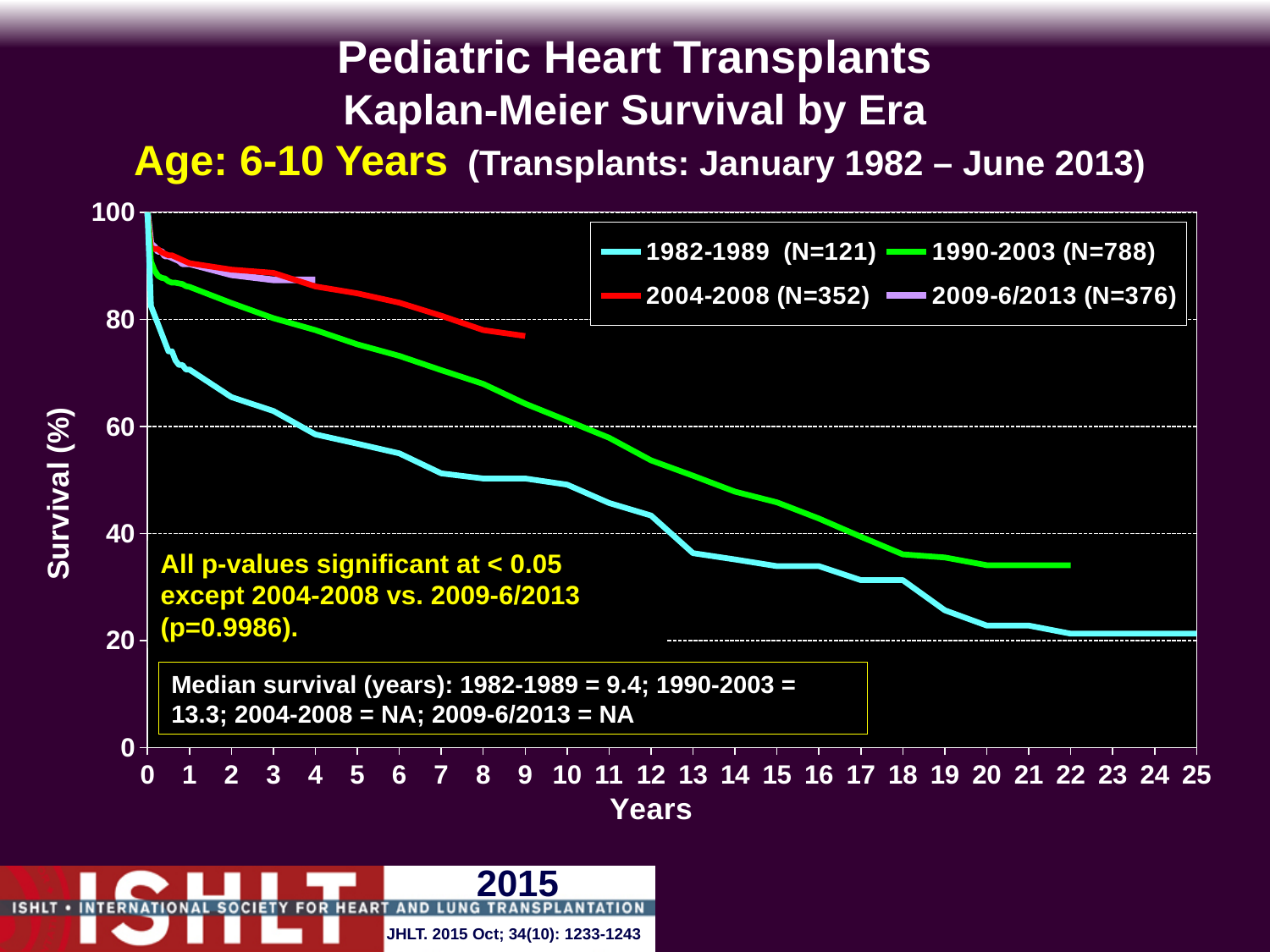
Do the survival curves rise or fall as years increase? fall At 5 years, which era has the lowest survival? 1982-1989 How many series does the legend list? 4 Is the survival value for the 2004-2008 era at 5 years greater or less than 80? greater Is the survival value for the 1990-2003 era at 5 years greater or less than 60? greater What is the median survival in years for the 1990-2003 era, as stated on the slide? 13.3 Is the survival value for the 1982-1989 era at 10 years greater or less than 60? less According to the legend, how many transplants (N) are in the 1982-1989 era? 121 What colour is the line for the 2004-2008 era? red What kind of chart is shown on the slide? line chart At 10 years, which era has higher survival: 1982-1989 or 1990-2003? 1990-2003